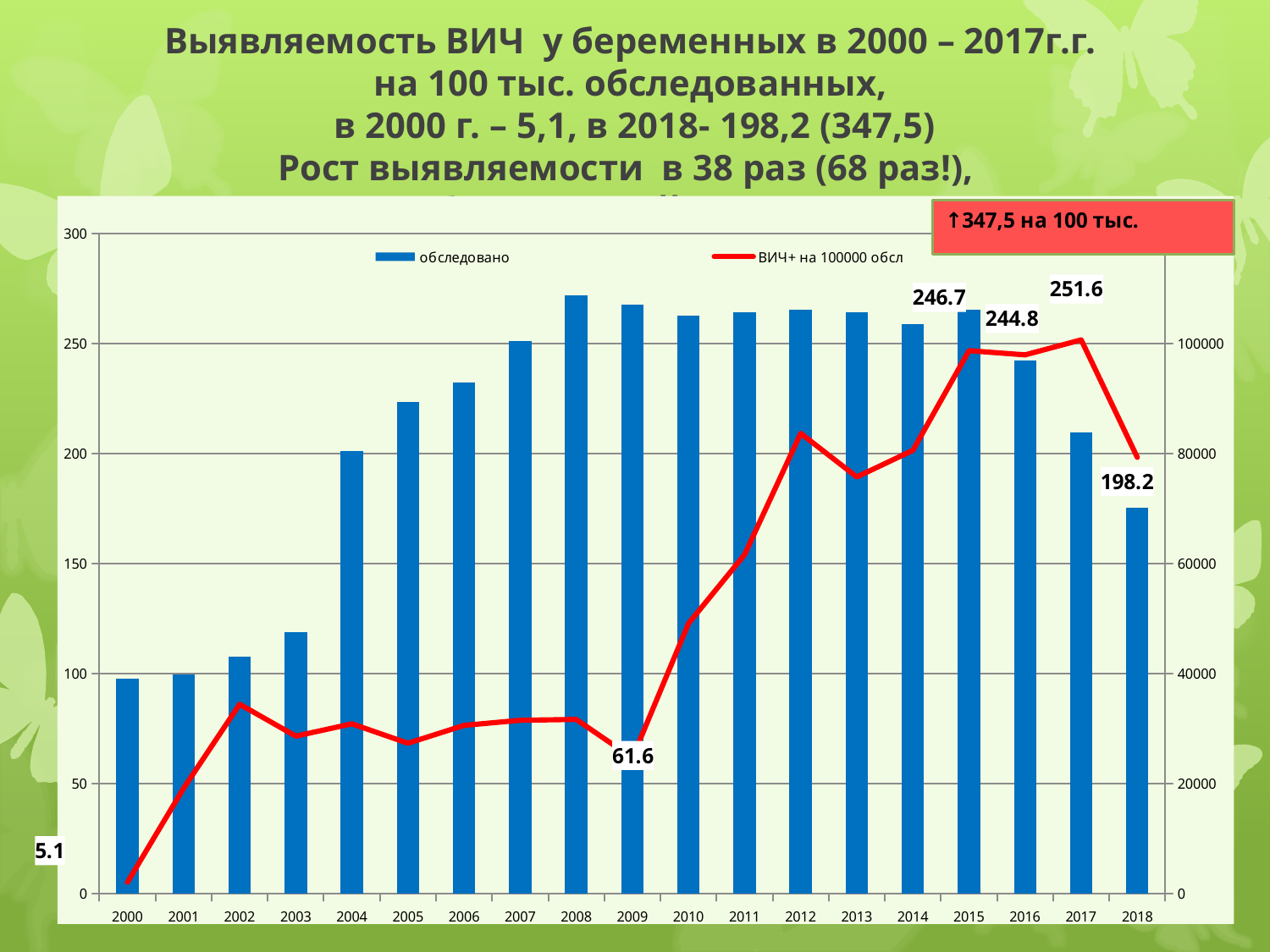
Which year has the larger ВИЧ+ на 100000 обсл value, 2015 or 2016? 2015 Which year has the lowest value on the ВИЧ+ на 100000 обсл line? 2000 How many series does the legend list? 2 What is the difference between the ВИЧ+ на 100000 обсл values for 2017 and 2018? 53.4 What is the value of the ВИЧ+ на 100000 обсл line for 2018? 198.2 What is the value of the ВИЧ+ на 100000 обсл line for 2009? 61.6 What is the value of the ВИЧ+ на 100000 обсл line for 2000? 5.1 What kind of chart is shown on the slide? Combined bar and line chart Is the обследовано bar for 2018 greater or less than 80000? less How many years are shown on the x axis? 19 What is the value of the ВИЧ+ на 100000 обсл line for 2017? 251.6 Which year has the highest value on the ВИЧ+ на 100000 обсл line? 2017